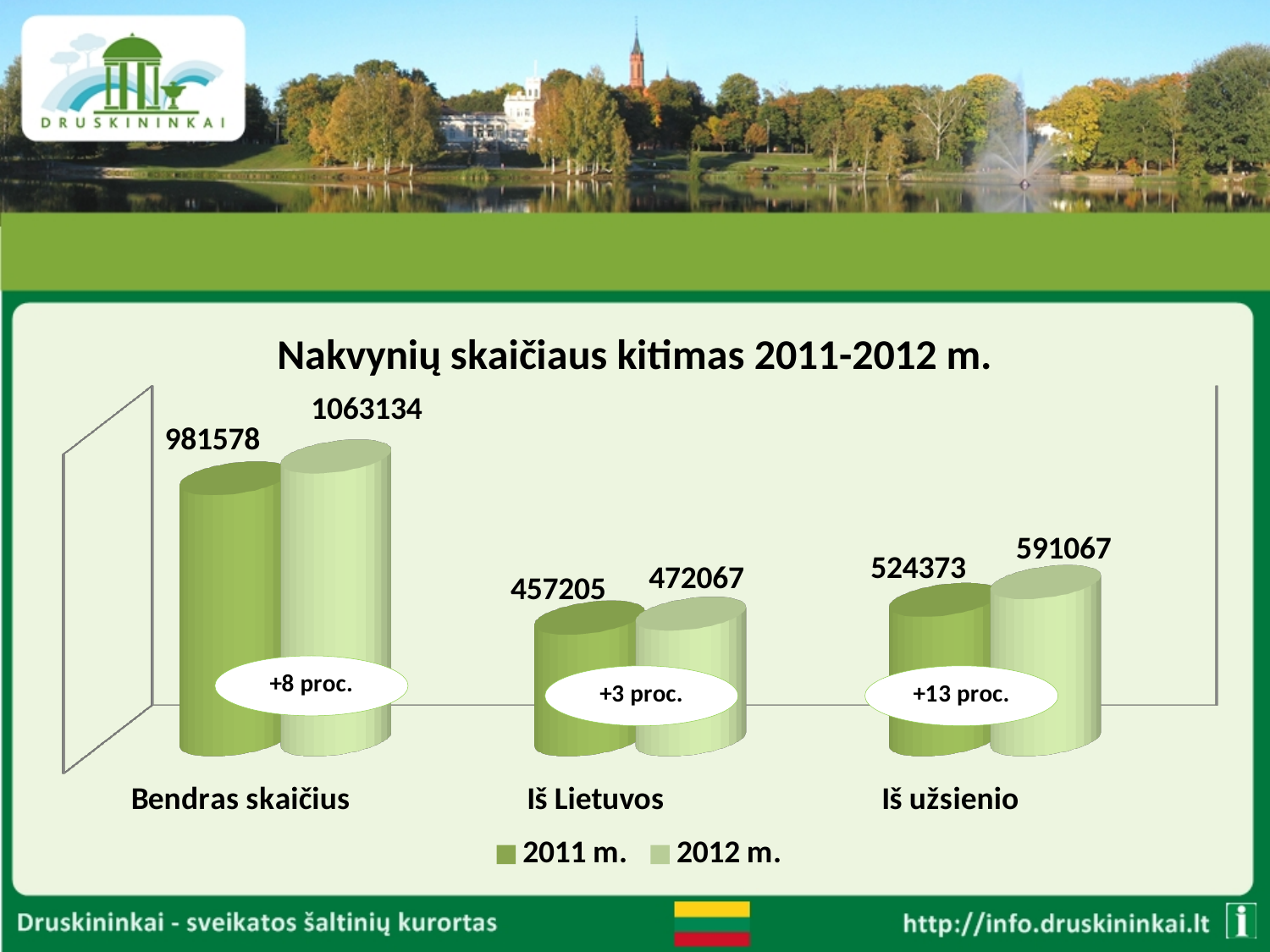
Which category has the highest value for 2012 m.? Bendras skaičius What is the value for 2011 m. in the Bendras skaičius category? 981578 What is the value for 2012 m. in the Iš užsienio category? 591067 What is the value for 2011 m. in the Iš Lietuvos category? 457205 What is the difference between the 2012 m. and 2011 m. values for Bendras skaičius? 81556 Which category has the lowest value for 2011 m.? Iš Lietuvos Which is larger: the 2011 m. value for Iš Lietuvos or the 2011 m. value for Iš užsienio? Iš užsienio What percentage change is annotated for the Iš užsienio category? +13 proc. What is the difference between the 2012 m. and 2011 m. values for Iš užsienio? 66694 How many series does the legend list? 2 How many categories are shown on the x axis? 3 What is the value for 2012 m. in the Bendras skaičius category? 1063134